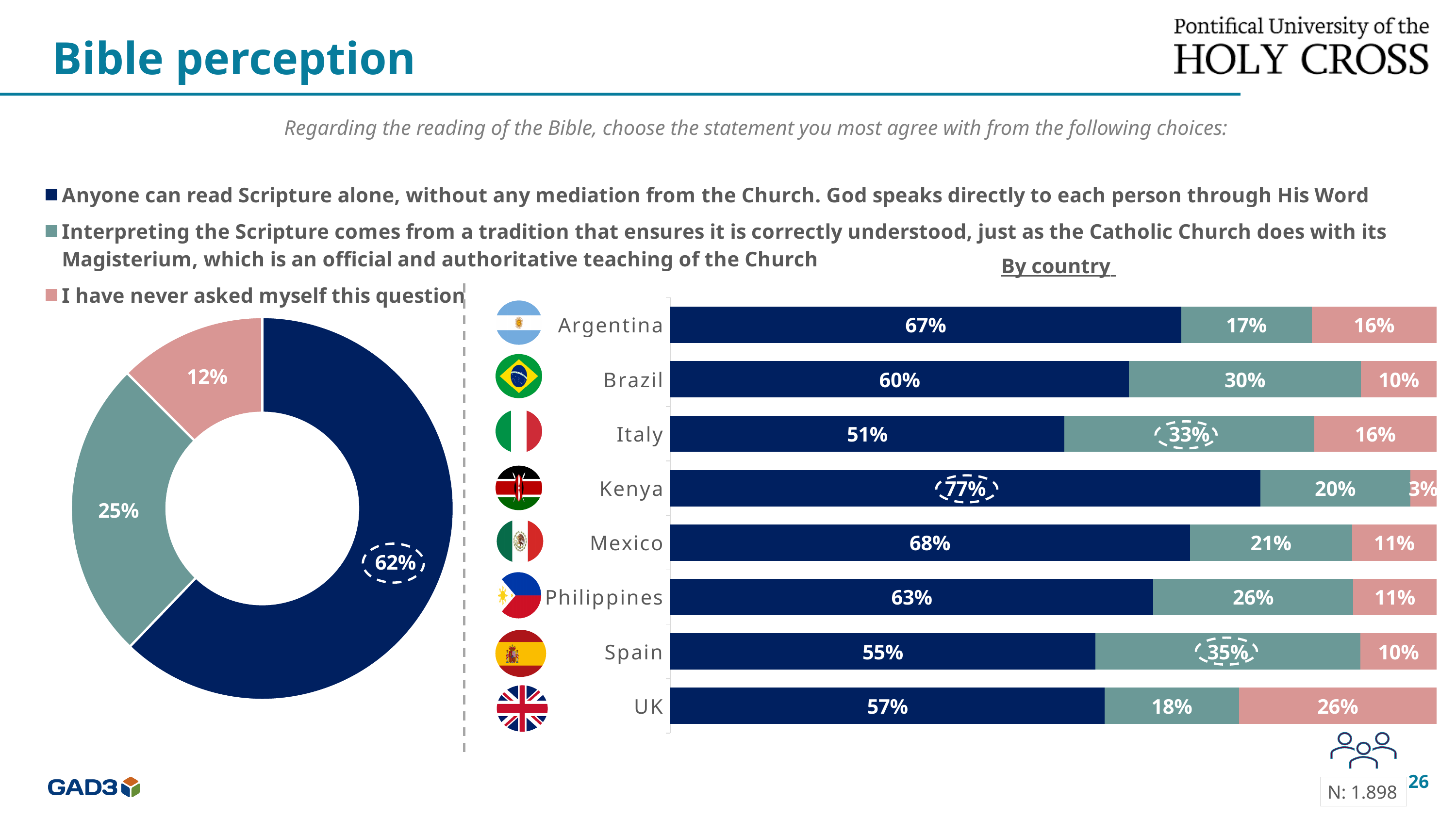
In the 'By country' chart, what percentage of respondents in the UK said 'I have never asked myself this question'? 26% What kind of chart is the chart on the left of the slide? Donut (pie) chart How many countries are shown in the 'By country' chart? 8 In the 'By country' chart, which is larger: Mexico's or Philippines' share for 'Anyone can read Scripture alone'? Mexico In the donut chart on the left, what share of respondents chose 'Anyone can read Scripture alone, without any mediation from the Church'? 62% In the donut chart on the left, what share of respondents said 'I have never asked myself this question'? 12% In the 'By country' chart, what percentage of respondents in Kenya chose 'Anyone can read Scripture alone'? 77% How many series does the legend list for the charts on this slide? 3 In the 'By country' chart, which country has the highest share for 'Anyone can read Scripture alone'? Kenya In the 'By country' chart, what is the difference between Brazil's and Argentina's shares for 'Interpreting the Scripture comes from a tradition...'? 13 percentage points In the 'By country' chart, which country has the highest share for 'Interpreting the Scripture comes from a tradition...'? Spain In the 'By country' chart, which country has the lowest share for 'Anyone can read Scripture alone'? Italy